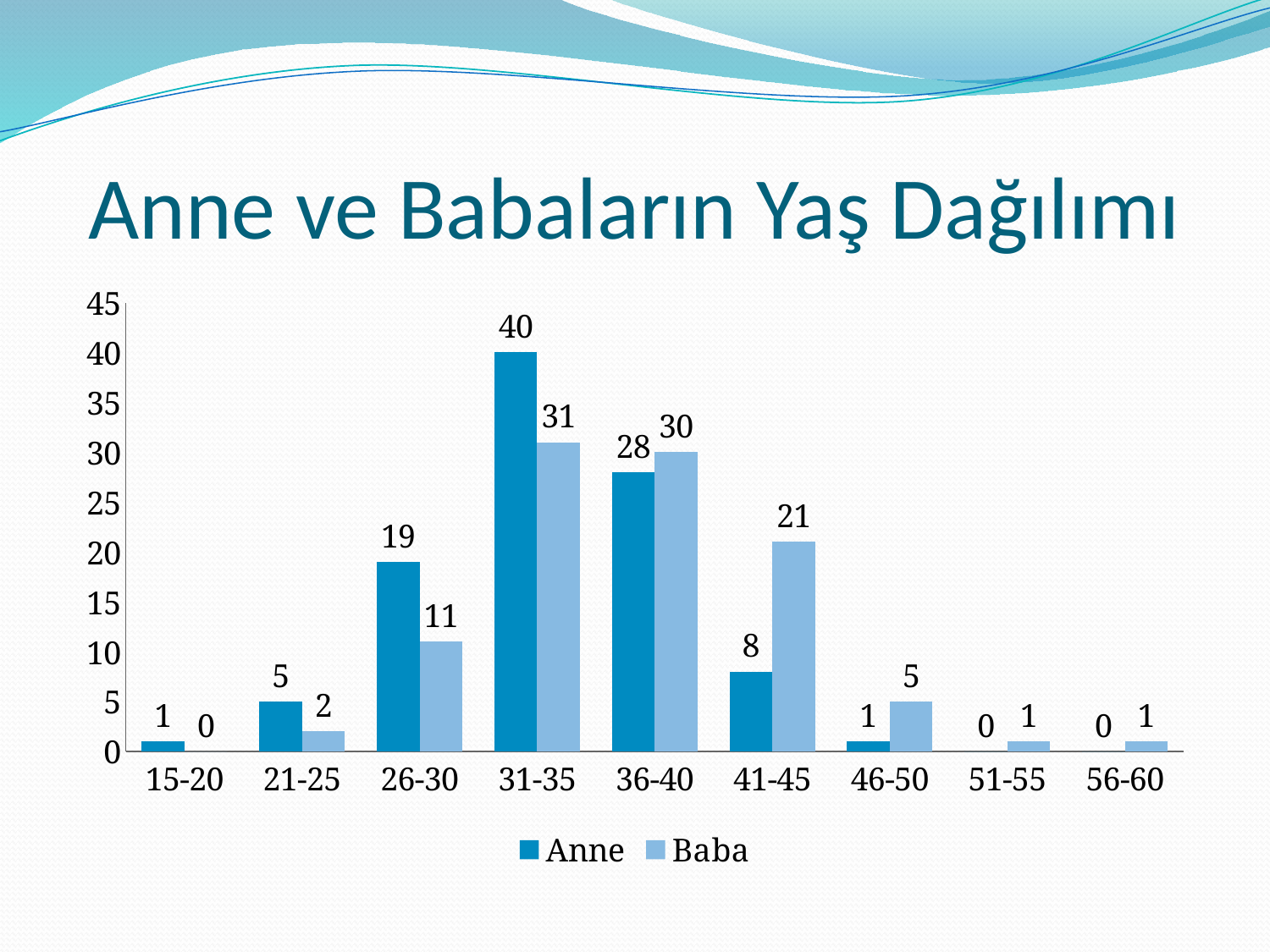
What is the value for Baba in the 26-30 age group? 11 What is the value for Anne in the 31-35 age group? 40 What is the difference between the Baba and Anne values in the 41-45 age group? 13 In the 36-40 age group, which is larger, Anne or Baba? Baba Which age group has the highest value for Anne? 31-35 What kind of chart is shown on the slide? Bar chart Which age group has the highest value for Baba? 31-35 What is the value for Baba in the 41-45 age group? 21 What is the title of the chart on the slide? Anne ve Babaların Yaş Dağılımı What is the difference between the Anne and Baba values in the 31-35 age group? 9 How many age groups are shown on the x axis? 9 How many series does the legend list? 2